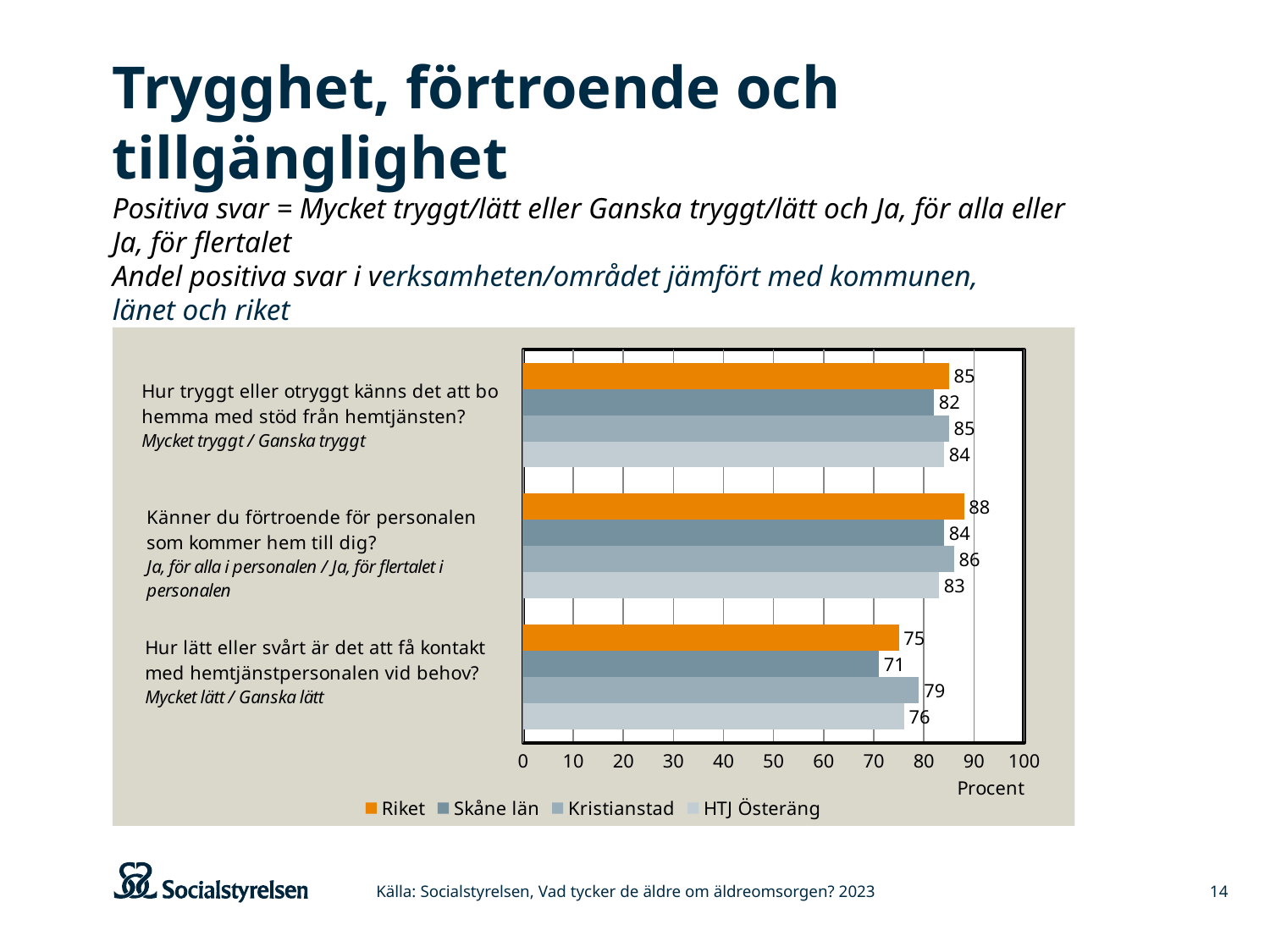
What is the difference between Riket and Skåne län on the question "Hur lätt eller svårt är det att få kontakt med hemtjänstpersonalen vid behov?"? 4 Is the value for Skåne län on the question "Hur lätt eller svårt är det att få kontakt med hemtjänstpersonalen vid behov?" greater or less than 80? less Which is larger on the question "Känner du förtroende för personalen som kommer hem till dig?": Kristianstad or HTJ Österäng? Kristianstad What is the value for Skåne län on the question "Hur tryggt eller otryggt känns det att bo hemma med stöd från hemtjänsten?"? 82 What is the value for HTJ Österäng on the question "Hur lätt eller svårt är det att få kontakt med hemtjänstpersonalen vid behov?"? 76 How many series does the legend list? 4 How many question categories are shown in the chart? 3 Which series has the lowest value on the question "Känner du förtroende för personalen som kommer hem till dig?"? HTJ Österäng What is the value for Riket on the question "Känner du förtroende för personalen som kommer hem till dig?"? 88 What kind of chart is shown on the slide? Bar chart What is the label on the x axis of the chart? Procent Which series has the highest value on the question "Hur lätt eller svårt är det att få kontakt med hemtjänstpersonalen vid behov?"? Kristianstad